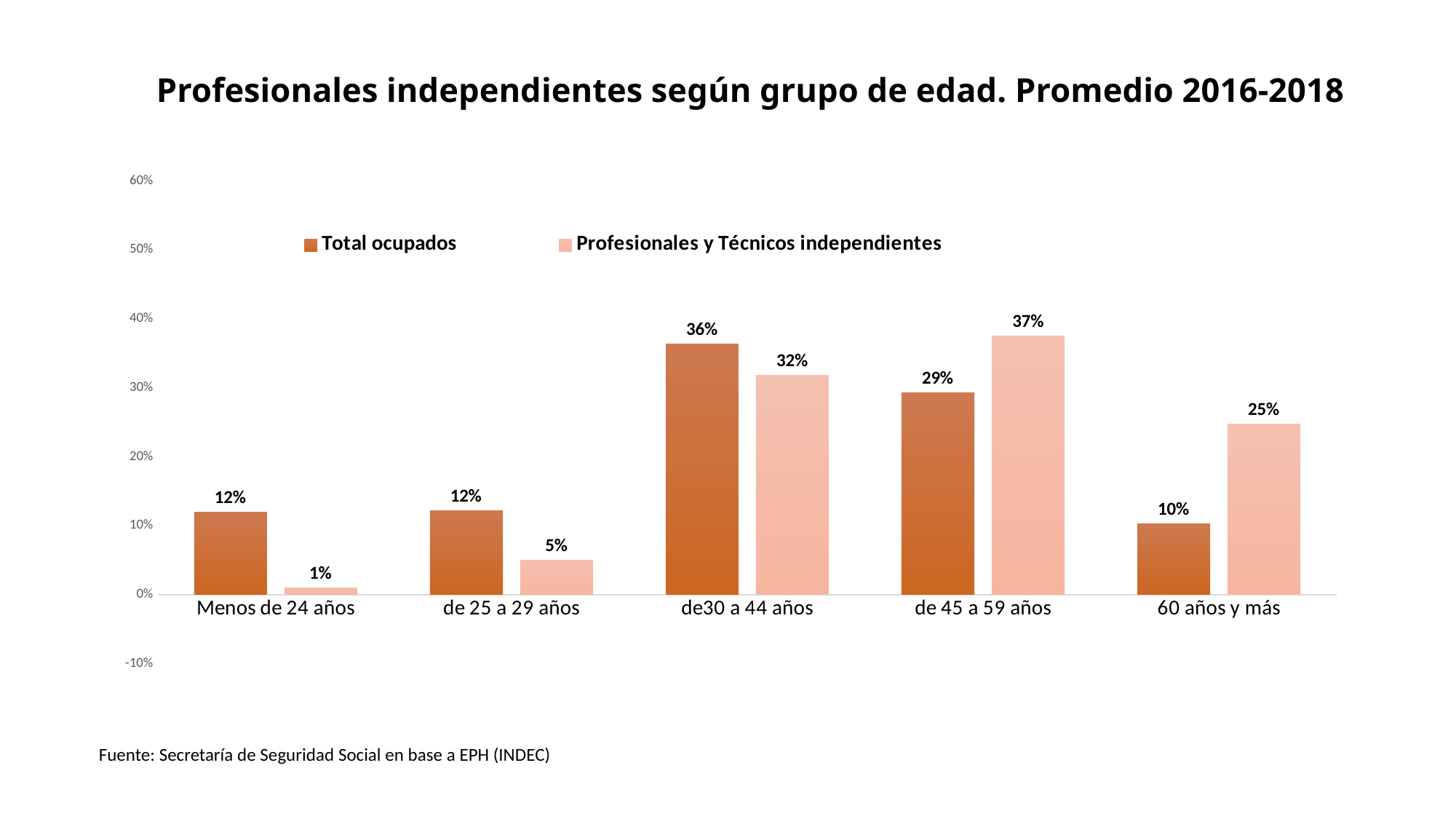
In the 'de 25 a 29 años' age group, which series has the larger value, Total ocupados or Profesionales y Técnicos independientes? Total ocupados How many age groups are shown on the x axis? 5 What is the value for Profesionales y Técnicos independientes in the 'Menos de 24 años' age group? 1% What is the title of the chart? Profesionales independientes según grupo de edad. Promedio 2016-2018 Is the value for Profesionales y Técnicos independientes in the 'de30 a 44 años' age group greater or less than 30%? greater What is the value for Profesionales y Técnicos independientes in the '60 años y más' age group? 25% Which age group has the lowest value for Total ocupados? 60 años y más Which age group has the highest value for Profesionales y Técnicos independientes? de 45 a 59 años What kind of chart is shown on the slide? Bar chart What is the value for Total ocupados in the 'de30 a 44 años' age group? 36% How many series does the legend list? 2 What is the difference between Profesionales y Técnicos independientes and Total ocupados in the 'de 45 a 59 años' age group? 8%